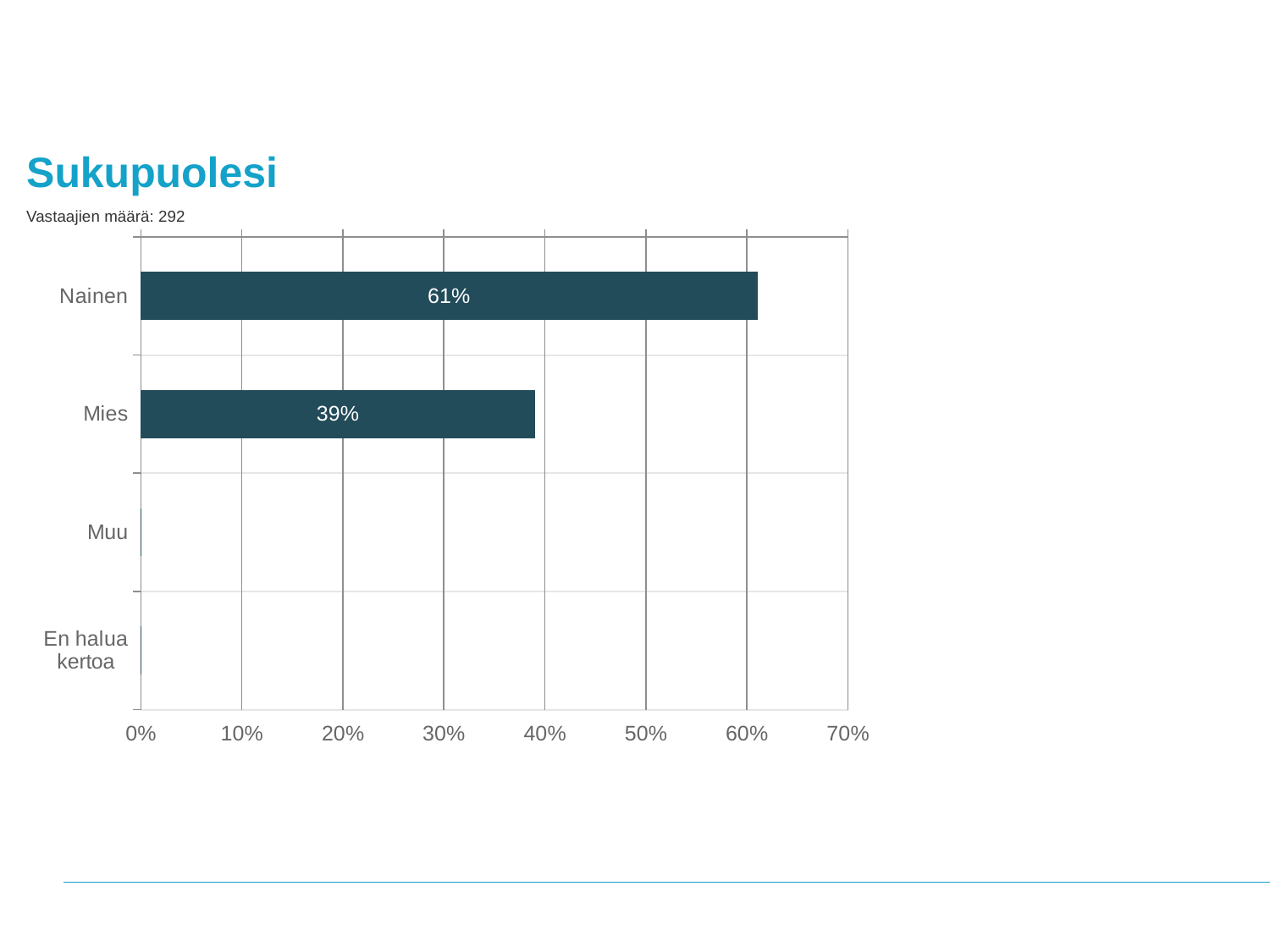
What is the title of the chart? Sukupuolesi Is the value for Muu greater or less than 10%? less Is the value for Mies greater or less than 40%? less What kind of chart is shown on the slide? bar chart Which category has the highest value? Nainen Is the value for Nainen greater or less than 60%? greater How many respondents (Vastaajien määrä) are stated on the slide? 292 What is the value for Mies? 39% What is the value for Nainen? 61% Which is larger, the value for Nainen or the value for Mies? Nainen How many categories are shown on the chart? 4 What is the difference between the values for Nainen and Mies? 22%